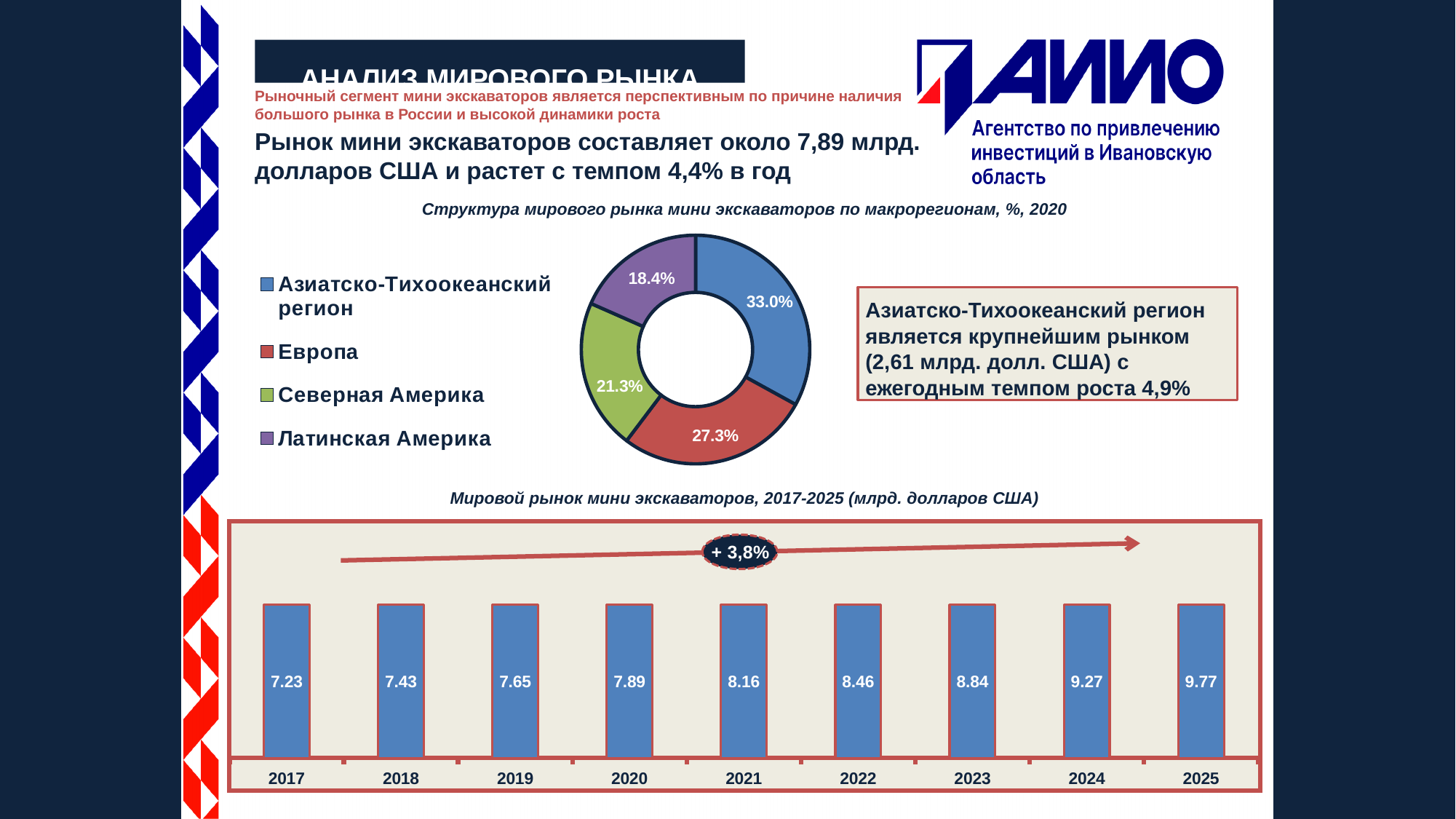
In the chart 'Мировой рынок мини экскаваторов, 2017-2025 (млрд. долларов США)', what is the difference between the values for 2025 and 2017? 2.54 What kind of chart is 'Мировой рынок мини экскаваторов, 2017-2025 (млрд. долларов США)'? Bar chart In the chart 'Мировой рынок мини экскаваторов, 2017-2025 (млрд. долларов США)', how many years are shown? 9 In the chart 'Структура мирового рынка мини экскаваторов по макрорегионам, %, 2020', which region has the largest share? Азиатско-Тихоокеанский регион In the chart 'Структура мирового рынка мини экскаваторов по макрорегионам, %, 2020', how many regions are shown? 4 In the chart 'Структура мирового рынка мини экскаваторов по макрорегионам, %, 2020', what is the difference between the shares of Северная Америка and Латинская Америка? 2.9 percentage points In the chart 'Структура мирового рынка мини экскаваторов по макрорегионам, %, 2020', what share does Европа hold? 27.3% In the chart 'Мировой рынок мини экскаваторов, 2017-2025 (млрд. долларов США)', do the values rise or fall from 2017 to 2025? Rise In the chart 'Мировой рынок мини экскаваторов, 2017-2025 (млрд. долларов США)', what is the value for 2025? 9.77 In the chart 'Мировой рынок мини экскаваторов, 2017-2025 (млрд. долларов США)', what is the value for 2021? 8.16 What kind of chart is 'Структура мирового рынка мини экскаваторов по макрорегионам, %, 2020'? Pie (donut) chart In the chart 'Структура мирового рынка мини экскаваторов по макрорегионам, %, 2020', which region has the smallest share? Латинская Америка